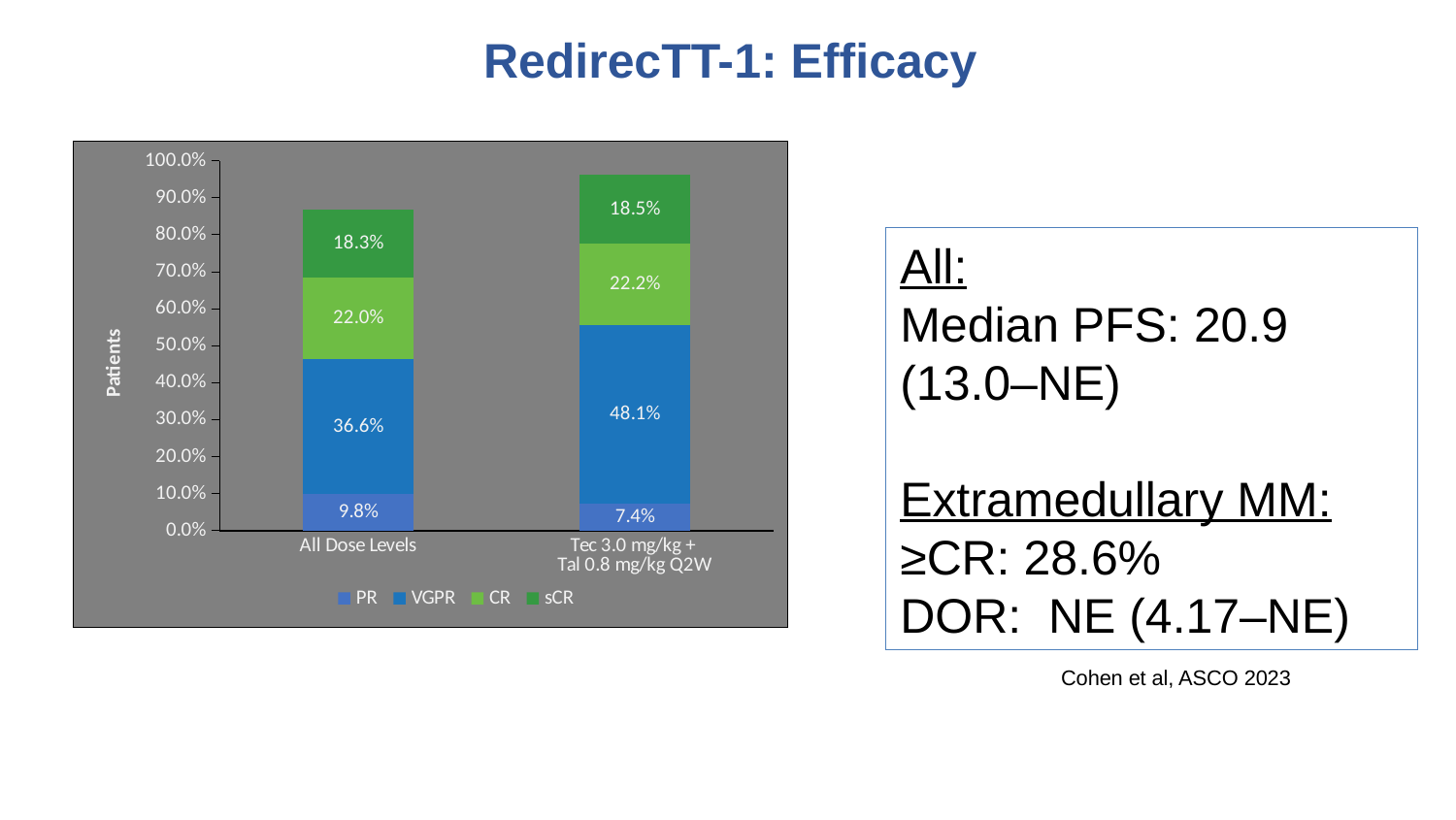
Which category has the larger PR value, All Dose Levels or Tec 3.0 mg/kg + Tal 0.8 mg/kg Q2W? All Dose Levels How many series does the chart legend list? 4 What is the VGPR value for All Dose Levels? 36.6% What kind of chart is shown on the slide? Stacked bar chart Which response category has the smallest segment in the Tec 3.0 mg/kg + Tal 0.8 mg/kg Q2W bar? PR How many categories are shown on the x axis of the chart? 2 What is the PR value for Tec 3.0 mg/kg + Tal 0.8 mg/kg Q2W? 7.4% What is the sCR value for All Dose Levels? 18.3% What is the difference between the VGPR values for Tec 3.0 mg/kg + Tal 0.8 mg/kg Q2W and All Dose Levels? 11.5% Which response category has the largest segment in the All Dose Levels bar? VGPR What is the CR value for Tec 3.0 mg/kg + Tal 0.8 mg/kg Q2W? 22.2% What is the total of the stacked bar for All Dose Levels? 86.7%